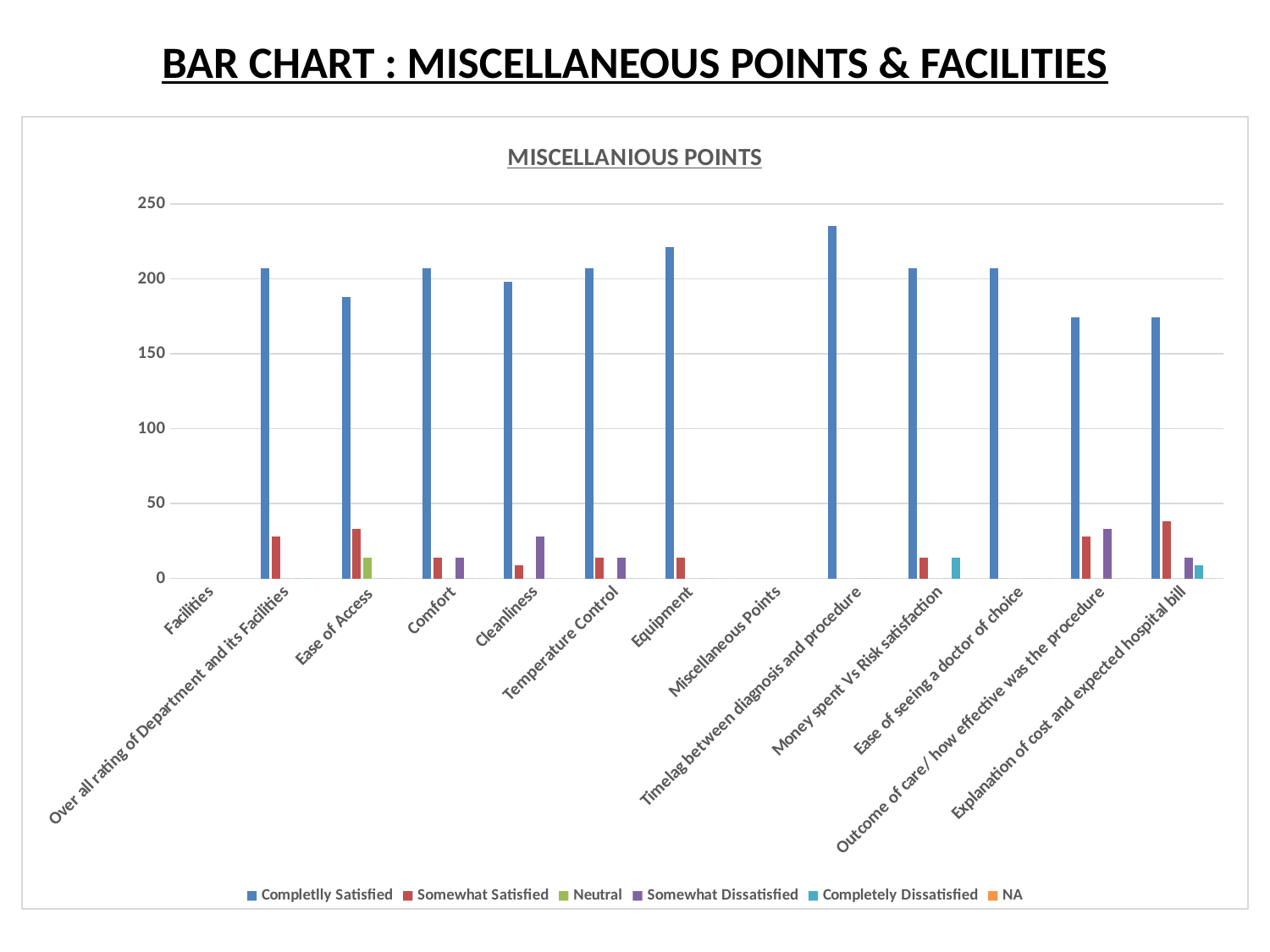
Is the Completlly Satisfied value for Ease of Access greater or less than 200? less What is the title printed inside the chart area? MISCELLANIOUS POINTS How many series does the chart legend list? 6 Is the Completlly Satisfied value for Outcome of care/ how effective was the procedure greater or less than 150? greater Which category has the tallest Completlly Satisfied bar? Timelag between diagnosis and procedure How many categories are shown along the x axis of the chart? 13 Is the Somewhat Satisfied value for Explanation of cost and expected hospital bill greater or less than 50? less Which has the larger Completlly Satisfied value, Equipment or Ease of Access? Equipment For which category is a Neutral bar shown? Ease of Access What kind of chart is shown on the slide? Bar chart Which has the larger Somewhat Satisfied value, Explanation of cost and expected hospital bill or Comfort? Explanation of cost and expected hospital bill